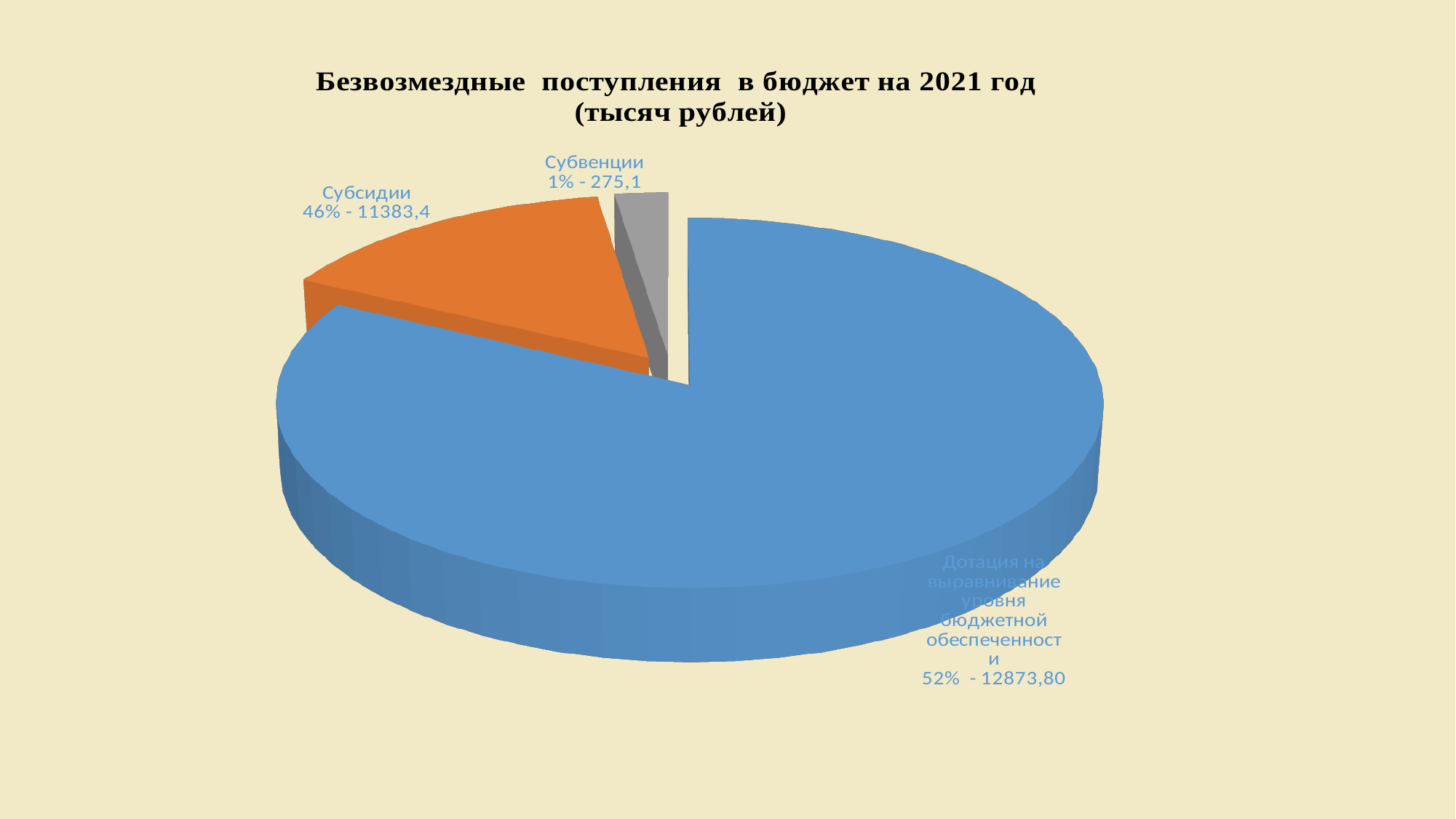
Which category has the largest slice of the pie? Дотация на выравнивание уровня бюджетной обеспеченности What is the difference between the value for Субсидии and the value for Субвенции? 11108,3 What is the value shown for Субсидии? 11383,4 What is the value shown for Дотация на выравнивание уровня бюджетной обеспеченности? 12873,80 How many slices does the pie chart have? 3 Which is larger, the value for Субсидии or the value for Субвенции? Субсидии What is the value shown for Субвенции? 275,1 Which category has the smallest slice of the pie? Субвенции What is the title of the chart? Безвозмездные поступления в бюджет на 2021 год (тысяч рублей) What share of the pie does Дотация на выравнивание уровня бюджетной обеспеченности represent? 52% What kind of chart is shown on the slide? Pie chart What share of the pie does Субсидии represent? 46%